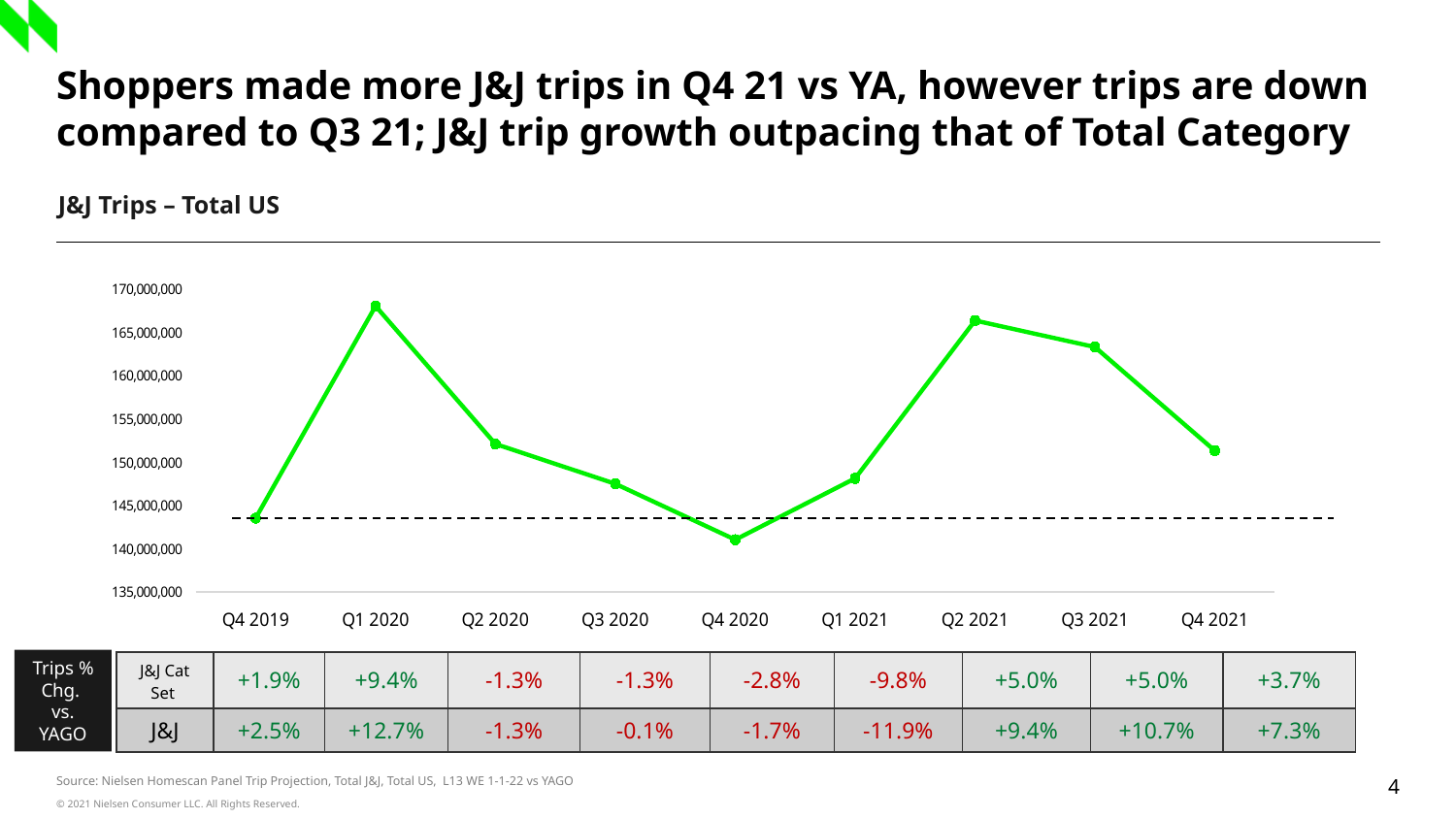
Is the value for Q1 2020 greater or less than 165,000,000? greater How many quarters are plotted on the x axis of the chart? 9 In the table below the chart, what is the J&J Cat Set Trips % Chg. vs. YAGO for Q1 2020? +9.4% What kind of chart is shown on the slide? line chart In the table below the chart, what is the J&J Trips % Chg. vs. YAGO for Q4 2021? +7.3% Which quarter has the highest number of J&J trips in the chart? Q1 2020 Which quarter has the lowest number of J&J trips in the chart? Q4 2020 Which quarter has more J&J trips, Q3 2021 or Q4 2021? Q3 2021 Which quarter has more J&J trips, Q2 2021 or Q3 2021? Q2 2021 Is the value for Q4 2019 greater or less than 145,000,000? less Do J&J trips rise or fall from Q1 2020 to Q4 2020? fall Is the value for Q4 2020 greater or less than 145,000,000? less